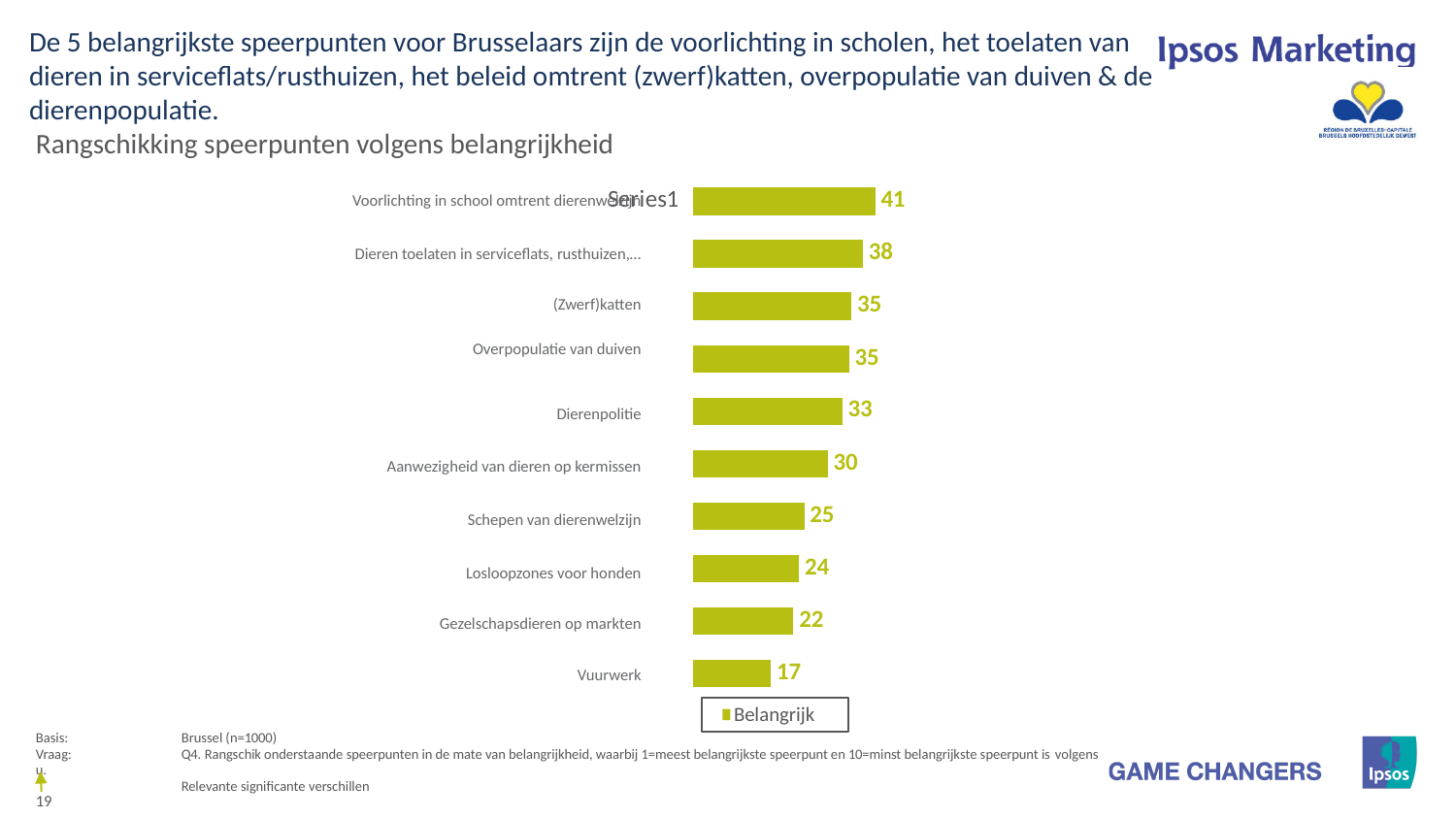
How many series does the legend list? 1 What is the value for Aanwezigheid van dieren op kermissen? 30 What is the value for Vuurwerk? 17 What is the value for Losloopzones voor honden? 24 What is the value for Dierenpolitie? 33 What is the highest value shown in the chart? 41 Which category has the lowest value? Vuurwerk What is the legend entry shown below the chart? Belangrijk How many categories are shown in the chart? 10 What is the difference between the values for Schepen van dierenwelzijn and Gezelschapsdieren op markten? 3 Which is larger, the value for Overpopulatie van duiven or the value for Dierenpolitie? Overpopulatie van duiven What type of chart is shown on the slide? bar chart